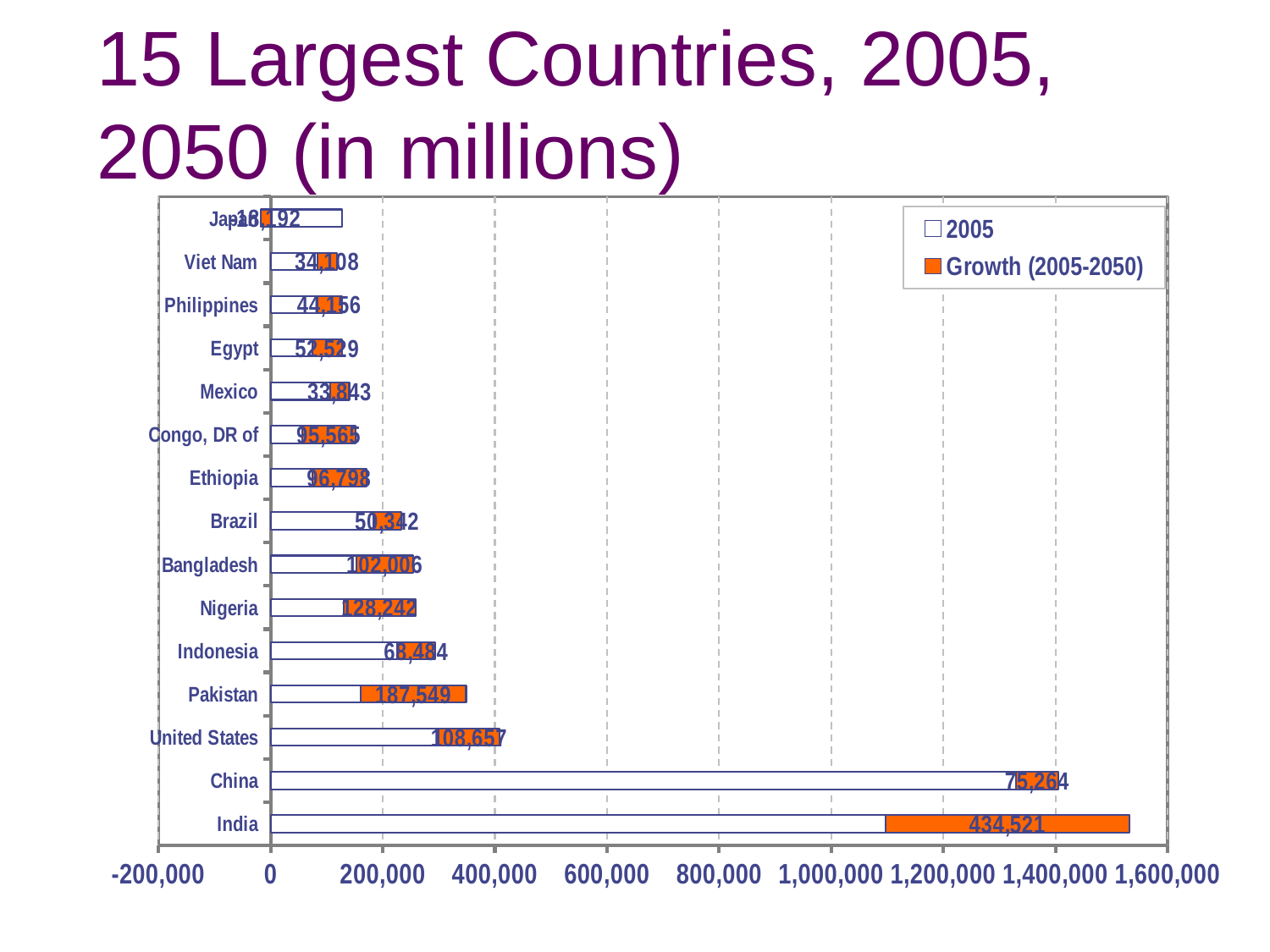
Is the 2005 value for China greater or less than 1,200,000? greater Which has the larger Growth (2005-2050) value, Pakistan or Nigeria? Pakistan What is the Growth (2005-2050) value for India? 434,521 What is the difference between the Growth (2005-2050) values for India and China? 359,257 What is the difference between the Growth (2005-2050) values for Pakistan and the United States? 78,892 What is the Growth (2005-2050) value for Nigeria? 128,242 What kind of chart is shown on the slide? bar chart How many countries are shown in the chart? 15 How many series does the legend list? 2 What is the Growth (2005-2050) value for the United States? 108,657 Which country has the largest Growth (2005-2050) value? India What is the Growth (2005-2050) value for Pakistan? 187,549